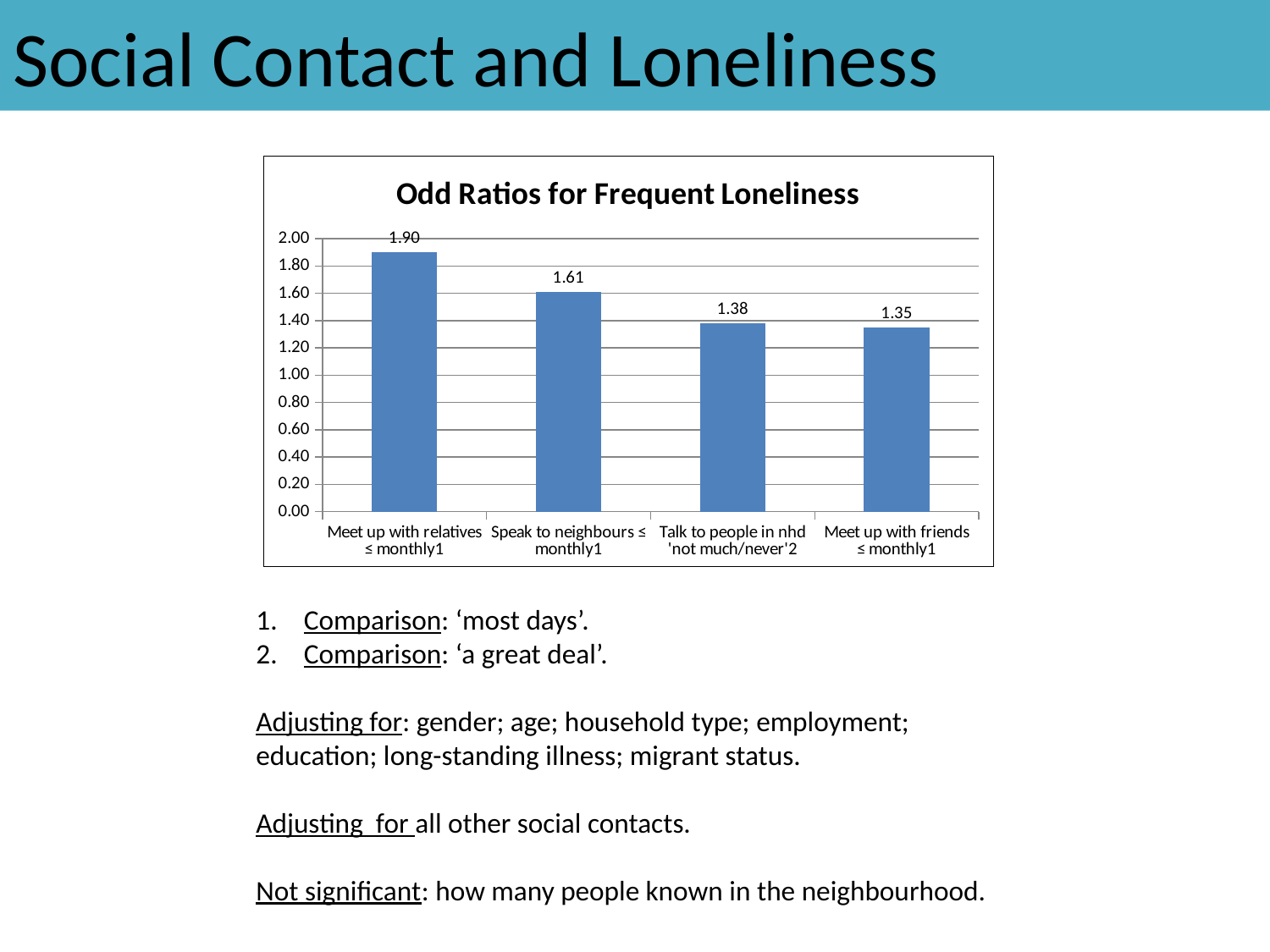
What is the odds ratio for 'Talk to people in nhd not much/never'? 1.38 What is the odds ratio for 'Meet up with relatives ≤ monthly'? 1.90 What is the odds ratio for 'Speak to neighbours ≤ monthly'? 1.61 What is the difference between the odds ratios for 'Meet up with relatives ≤ monthly' and 'Speak to neighbours ≤ monthly'? 0.29 How many categories are shown in the chart? 4 What kind of chart is shown on the slide? Bar chart What is the odds ratio for 'Meet up with friends ≤ monthly'? 1.35 Which category has the lowest odds ratio? Meet up with friends ≤ monthly What is the title of the chart? Odd Ratios for Frequent Loneliness Which category has the highest odds ratio? Meet up with relatives ≤ monthly Is the odds ratio for 'Meet up with friends ≤ monthly' greater or less than 1.00? greater Which has a larger odds ratio: 'Speak to neighbours ≤ monthly' or 'Talk to people in nhd not much/never'? Speak to neighbours ≤ monthly